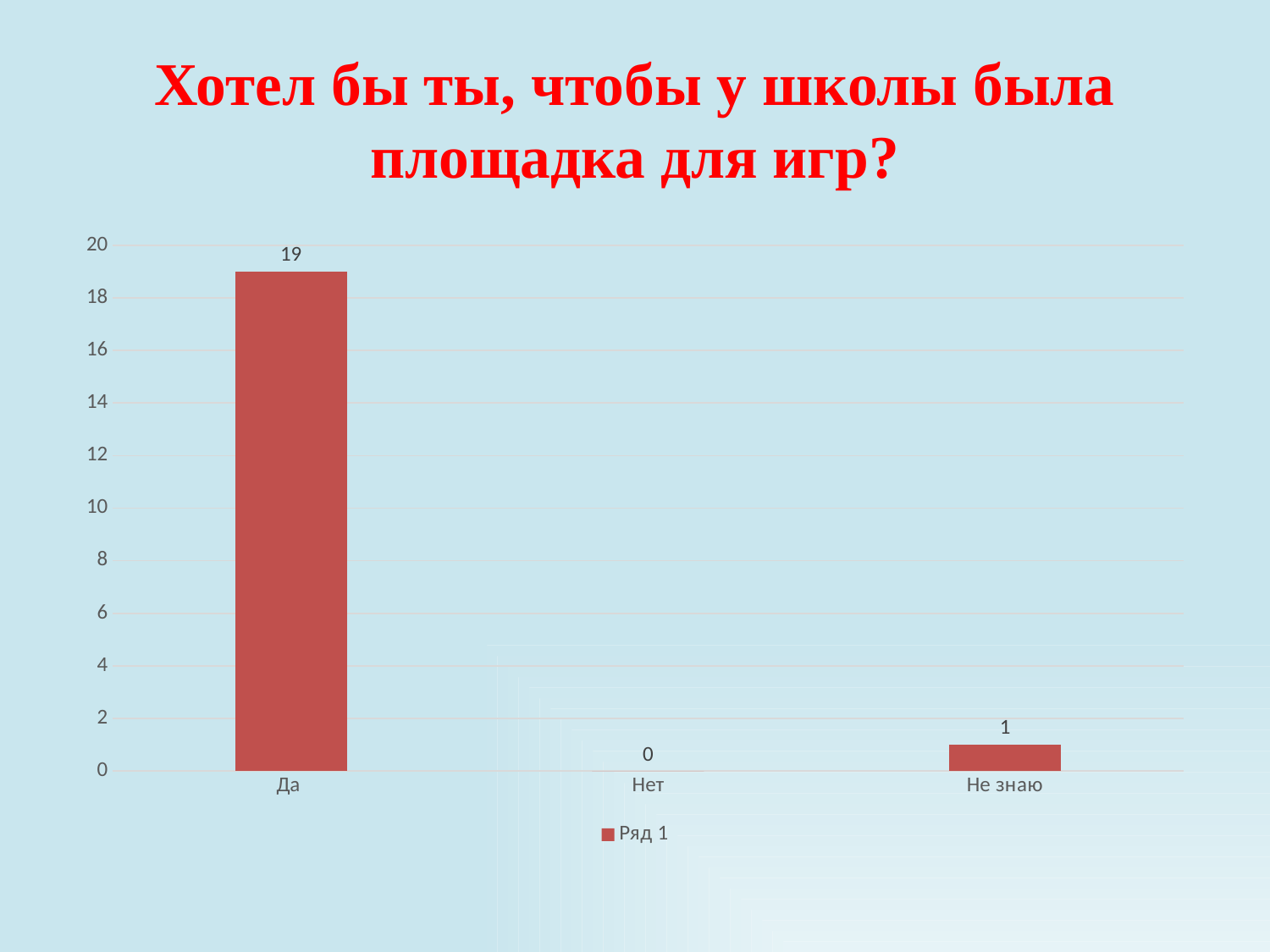
How many series does the legend list? 1 What is the value for "Да"? 19 What is the value for "Нет"? 0 Which category has the lowest value? Нет Which category has the highest value? Да What kind of chart is shown on the slide? bar chart What is the difference between the values for "Да" and "Не знаю"? 18 Is the value for "Да" greater or less than 10? greater What is the name of the series shown in the legend? Ряд 1 Which is larger, the value for "Не знаю" or the value for "Нет"? Не знаю What is the value for "Не знаю"? 1 How many categories are shown on the x axis? 3